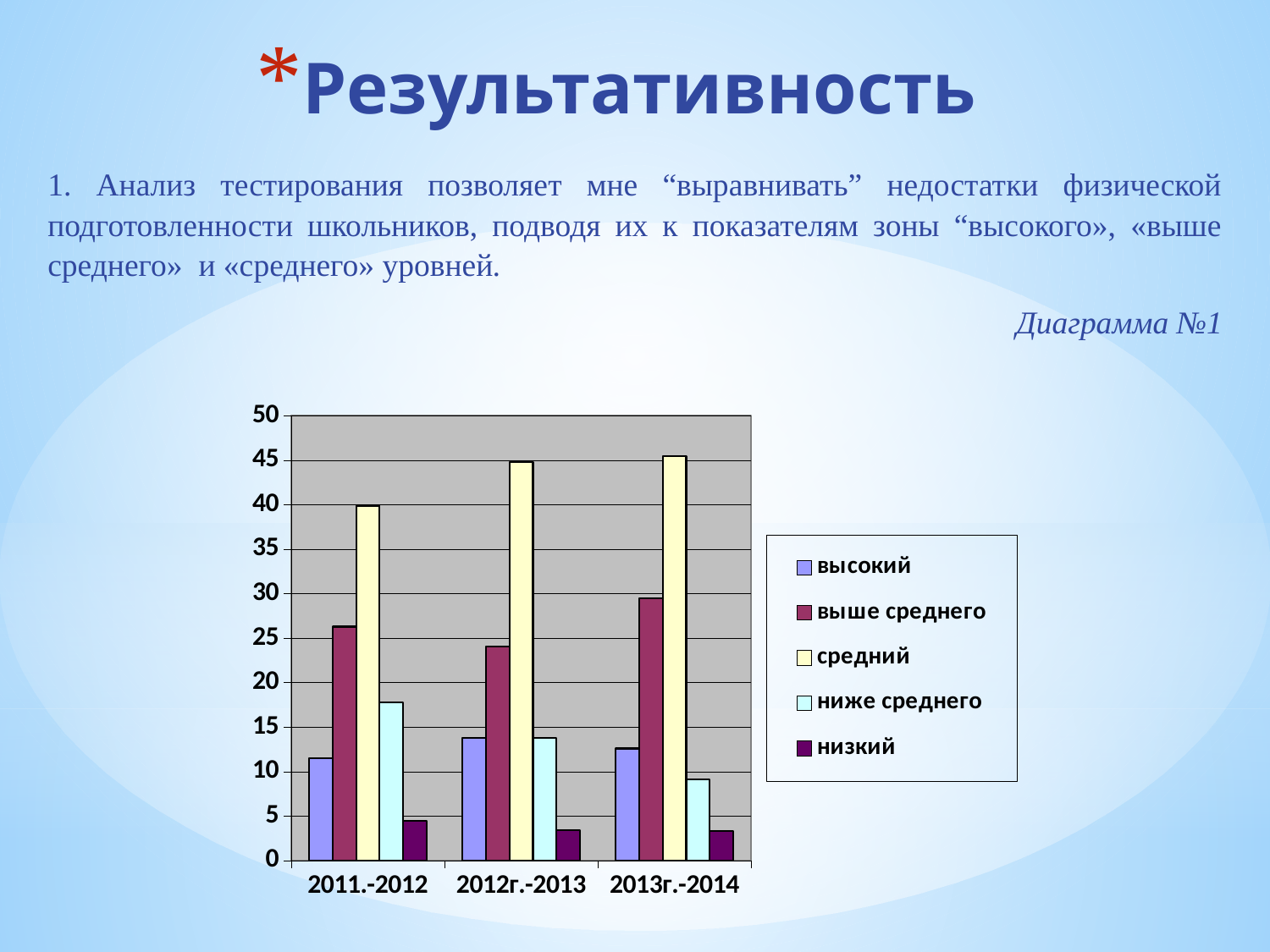
Is the value for низкий in 2011.-2012 greater or less than 10? less Is the value for средний in 2011.-2012 greater or less than 35? greater Which is larger: выше среднего in 2011.-2012 or выше среднего in 2012г.-2013? 2011.-2012 How many series does the chart legend list? 5 Does the value for ниже среднего rise or fall from 2011.-2012 to 2013г.-2014? fall Which series has the highest value in the 2013г.-2014 group? средний Is the value for выше среднего in 2013г.-2014 greater or less than 25? greater What is the label given to the chart above it on the slide? Диаграмма №1 What kind of chart is shown on the slide? bar chart How many year categories are shown on the x axis of the chart? 3 Which series has the lowest value in the 2011.-2012 group? низкий